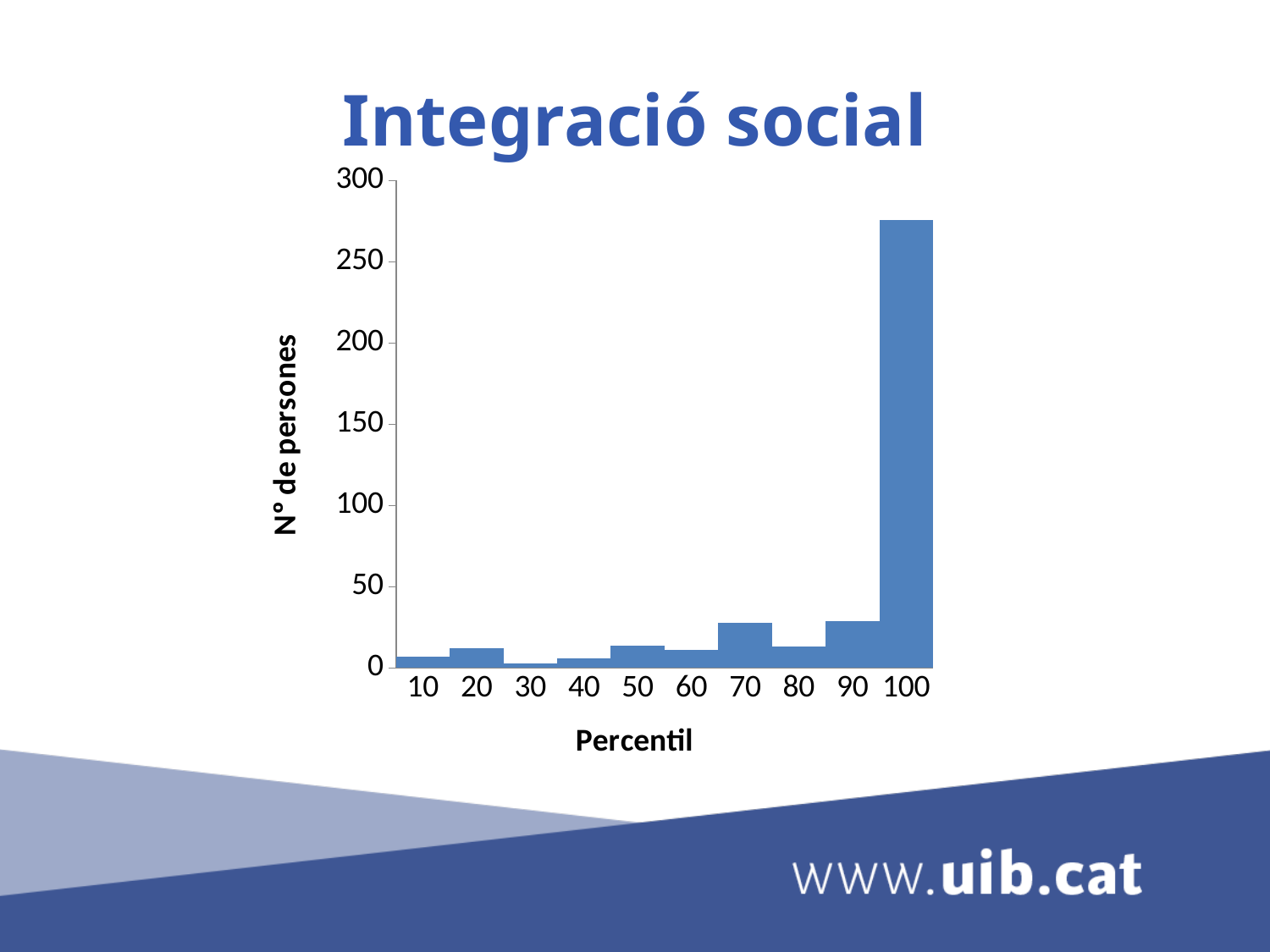
What is the title of the chart? Integració social Is the value for percentile 100 greater or less than 250? greater Which has more people, percentile 20 or percentile 30? 20 Is the value for percentile 10 greater or less than 50? less Which percentile has the highest number of people? 100 How many bars (percentile categories) are plotted in the chart? 10 What kind of chart is shown on the slide? bar chart What is the label of the vertical axis? Nº de persones Which has more people, percentile 70 or percentile 80? 70 Is the value for percentile 70 greater or less than 50? less Which has more people, percentile 100 or percentile 90? 100 Which percentile has the lowest number of people? 30